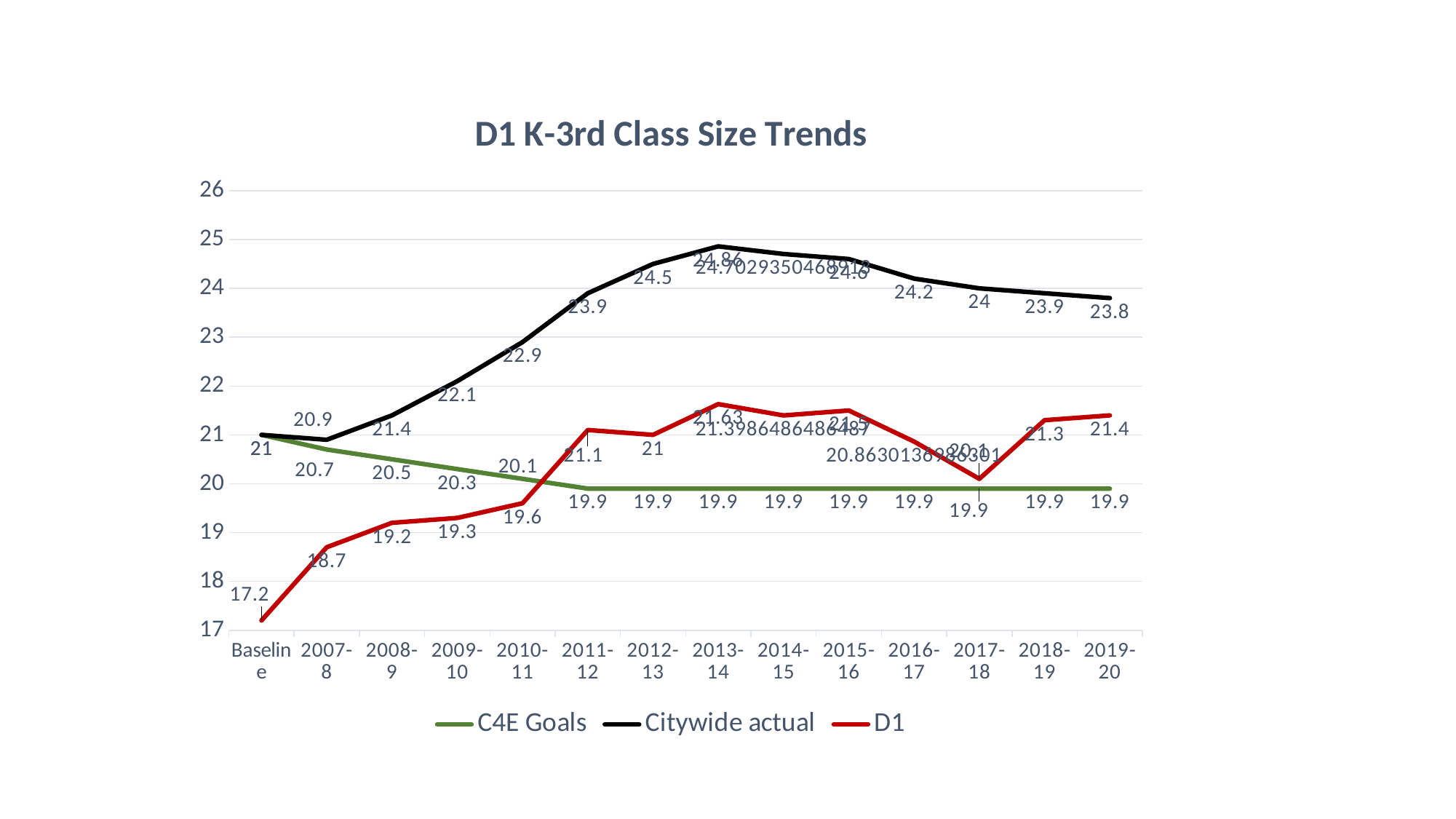
What is the title of the chart? D1 K-3rd Class Size Trends In 2011-12, which is larger: the D1 value or the C4E Goals value? D1 What is the difference between the Citywide actual value and the D1 value in 2012-13? 3.5 In which year is the Citywide actual value highest? 2013-14 What is the D1 value at Baseline? 17.2 How many series does the legend list? 3 Does the D1 line rise or fall from Baseline to 2010-11? rise What is the C4E Goals value for 2009-10? 20.3 How many categories are shown along the x axis? 14 What kind of chart is shown on the slide? line chart What is the Citywide actual value for 2019-20? 23.8 In which category is the D1 value lowest? Baseline